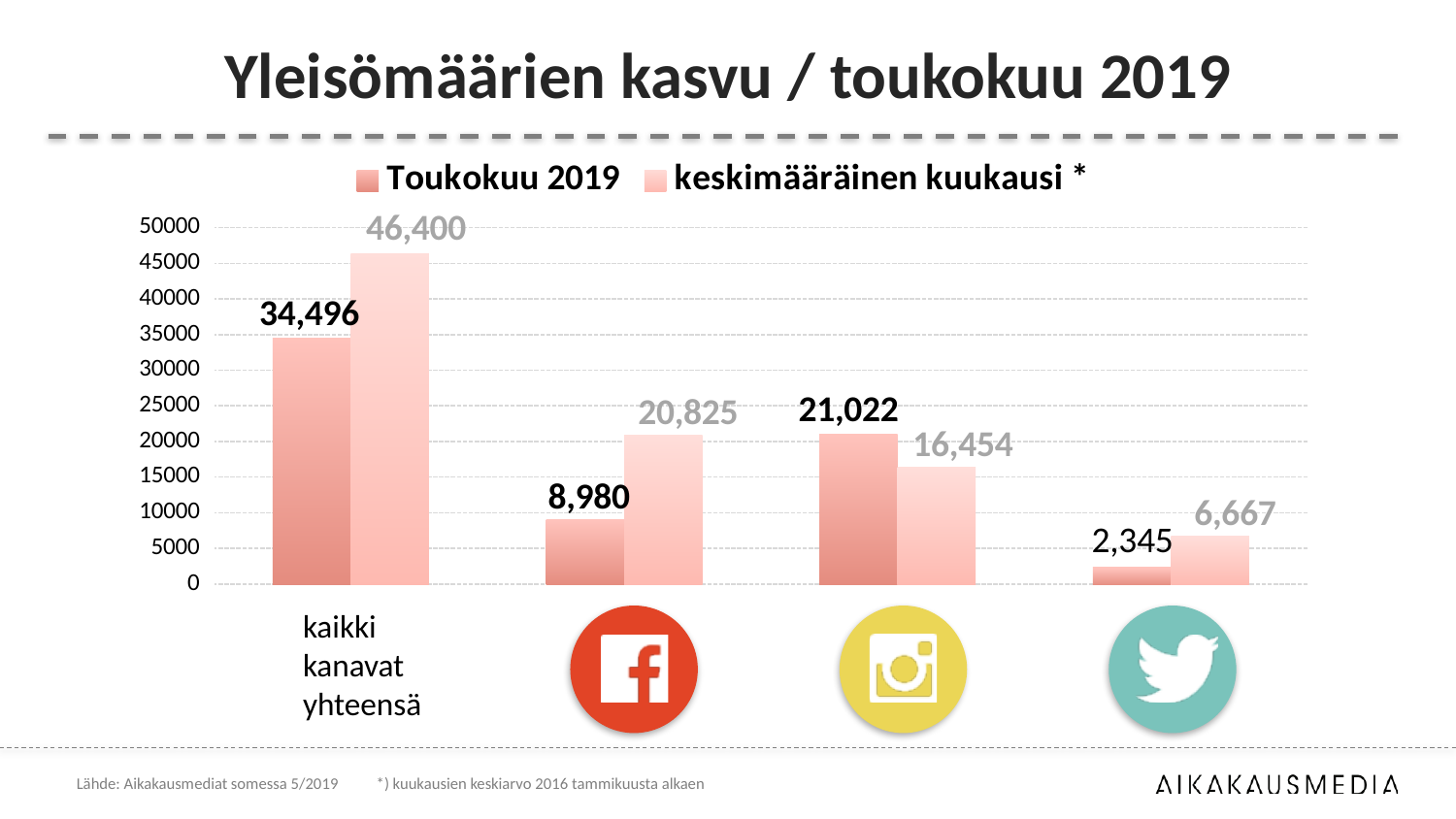
What is the value for "kaikki kanavat yhteensä" in the keskimääräinen kuukausi series? 46,400 What kind of chart is shown on the slide? Bar chart Which category has the highest keskimääräinen kuukausi value? kaikki kanavat yhteensä For the Instagram category, which is larger: the Toukokuu 2019 value or the keskimääräinen kuukausi value? Toukokuu 2019 How many categories are shown on the x axis? 4 What is the keskimääräinen kuukausi value for the Instagram category? 16,454 What is the Toukokuu 2019 value for the Twitter category? 2,345 What is the value for "kaikki kanavat yhteensä" in the Toukokuu 2019 series? 34,496 Which category has the lowest Toukokuu 2019 value? Twitter How many series does the legend list? 2 What is the difference between the keskimääräinen kuukausi value and the Toukokuu 2019 value for the Facebook category? 11,845 What is the Toukokuu 2019 value for the Facebook category? 8,980